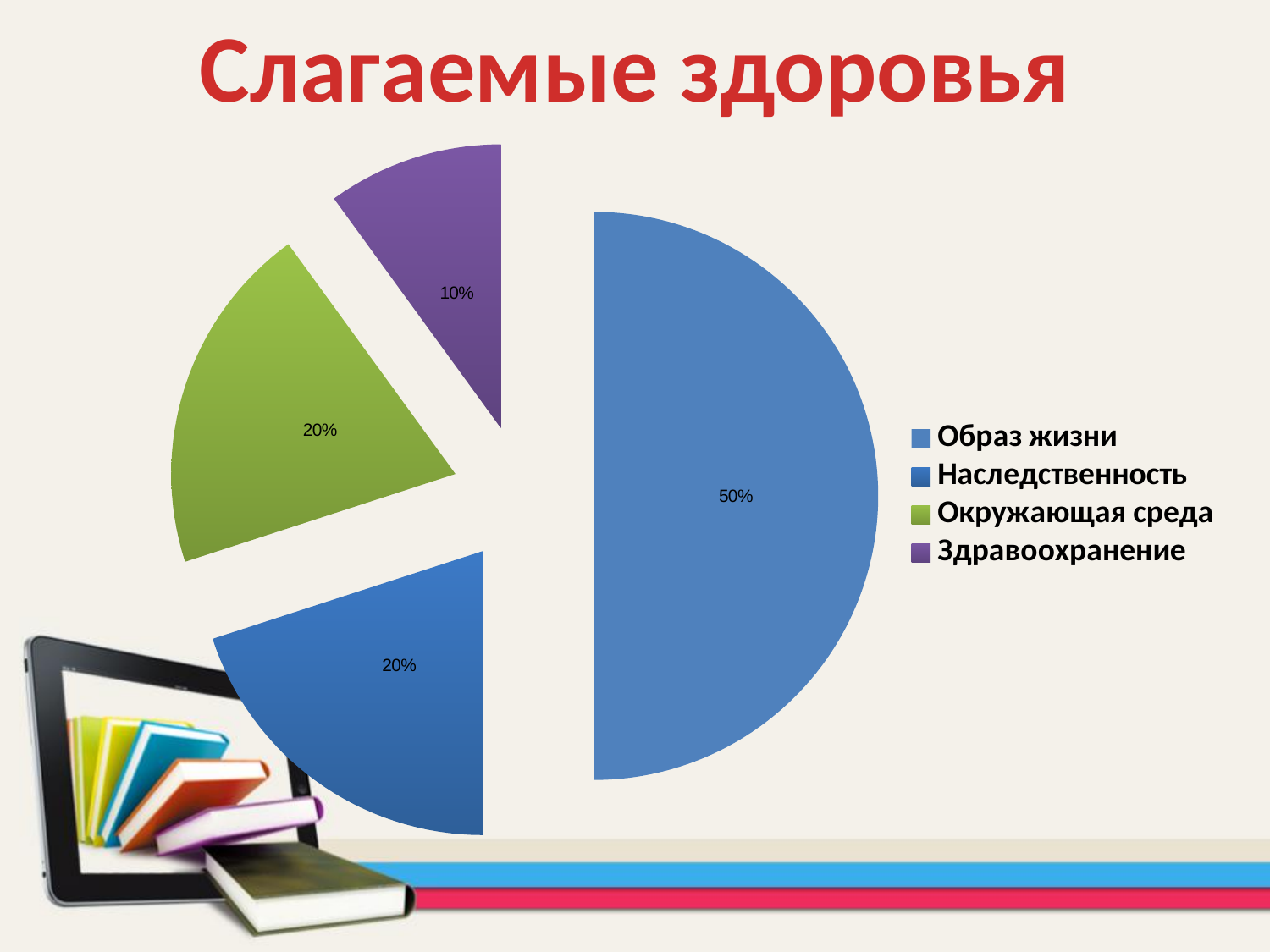
What share of the pie does Образ жизни have? 50% What is the title of the slide containing the pie chart? Слагаемые здоровья What share of the pie does Наследственность have? 20% Which is larger, the share of Образ жизни or the share of Окружающая среда? Образ жизни Which category has the smallest slice of the pie? Здравоохранение How many entries does the legend list? 4 What kind of chart is shown on the slide? pie chart What share of the pie does Здравоохранение have? 10% Which category has the largest slice of the pie? Образ жизни What share of the pie does Окружающая среда have? 20% What is the difference between the shares of Образ жизни and Здравоохранение? 40% How many slices does the pie chart have? 4